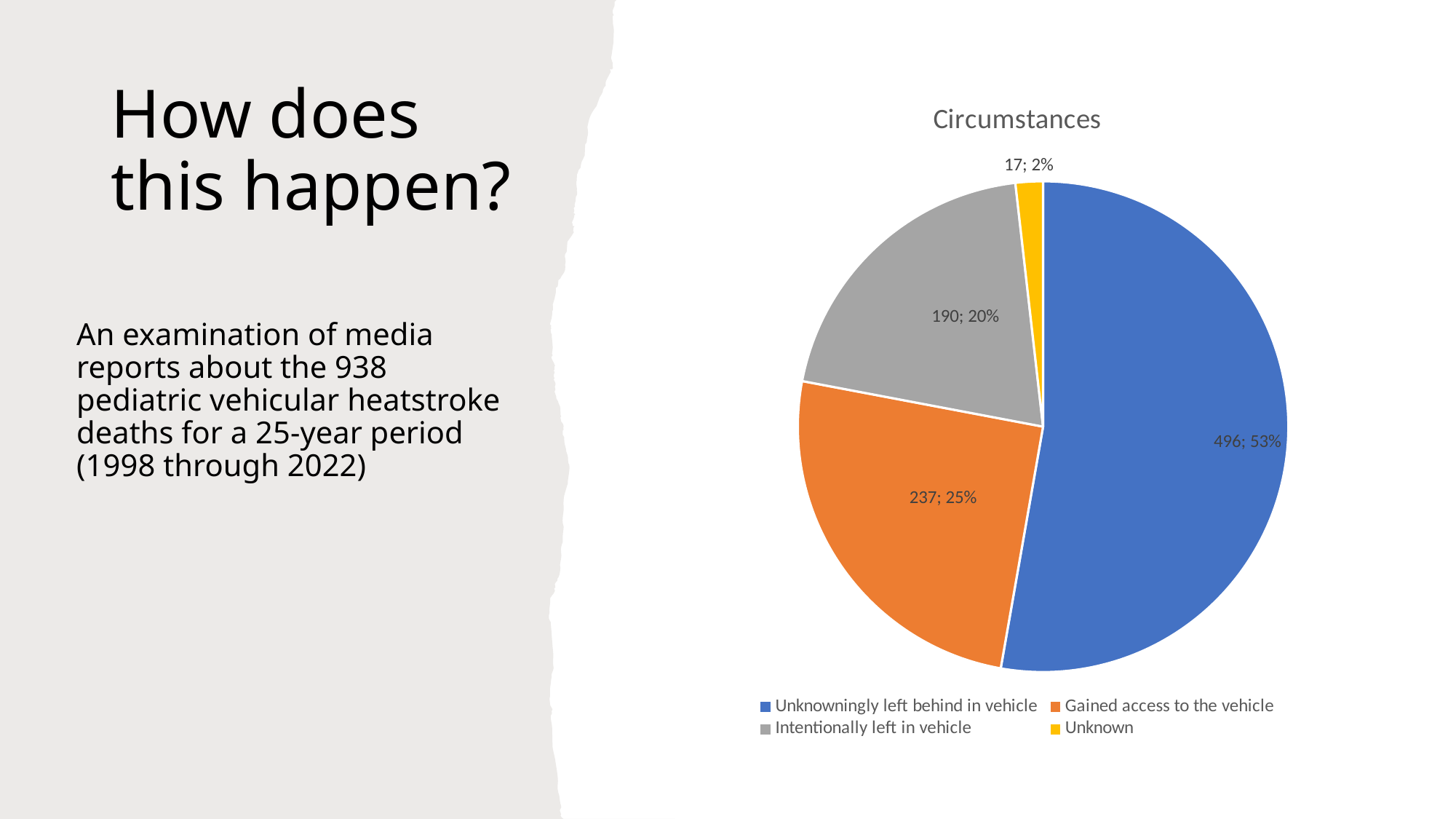
What is the value for 'Gained access to the vehicle'? 237 What is the title of the chart? Circumstances What is the difference between the values for 'Gained access to the vehicle' and 'Intentionally left in vehicle'? 47 What is the value for 'Unknowingly left behind in vehicle'? 496 What type of chart is shown on the slide? pie chart How many slices does the pie chart have? 4 What share of the pie does 'Intentionally left in vehicle' represent? 20% What is the value for 'Unknown'? 17 Which category has the smallest slice? Unknown How many entries does the legend list? 4 Which category has the largest slice? Unknowingly left behind in vehicle What is the value for 'Intentionally left in vehicle'? 190